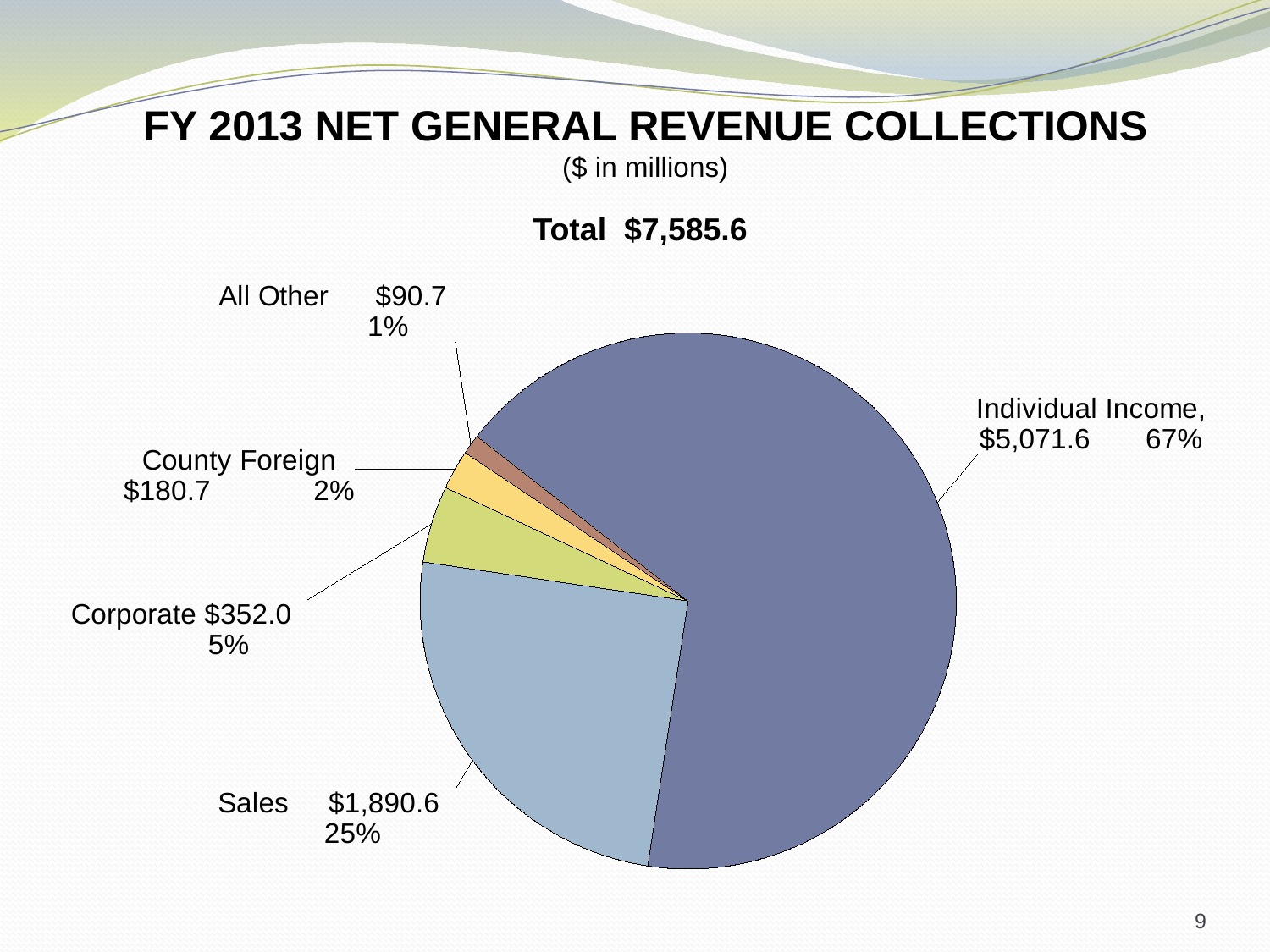
Which category has the smallest slice? All Other What is the difference between the Individual Income and Sales values? $3,181.0 How many slices does the pie chart have? 5 What is the value for Individual Income? $5,071.6 Which category has the largest slice? Individual Income What total is shown above the pie chart? $7,585.6 What is the value for Corporate? $352.0 What is the value for County Foreign? $180.7 What share of the pie does Sales represent? 25% What is the value for Sales? $1,890.6 What kind of chart is shown on the slide? Pie chart What share of the pie does All Other represent? 1%